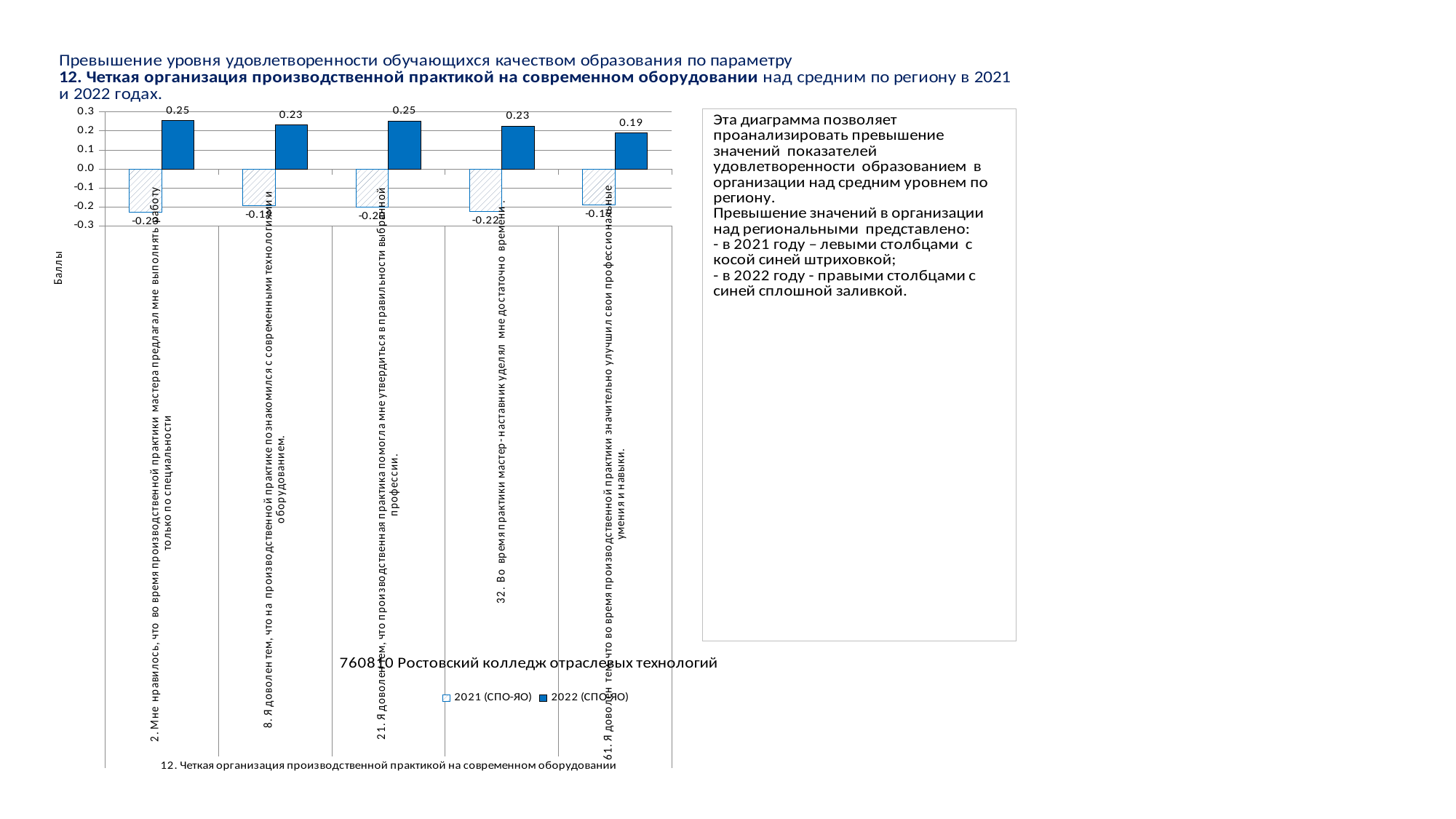
Which statement has the lowest 2022 (СПО-ЯО) value? 61. Я доволен тем, что во время производственной практики значительно улучшил свои профессиональные умения и навыки What is the title of the vertical axis? Баллы What is the 2022 (СПО-ЯО) value for statement 32 (Во время практики мастер-наставник уделял мне достаточно времени)? 0.23 How many series does the chart legend list? 2 Which has the larger 2022 (СПО-ЯО) value: statement 8 or statement 61? statement 8 What is the 2021 (СПО-ЯО) value for statement 32 (Во время практики мастер-наставник уделял мне достаточно времени)? -0.22 What kind of chart is shown on the slide? bar chart What is the 2022 (СПО-ЯО) value for statement 61 (Я доволен тем, что во время производственной практики значительно улучшил свои профессиональные умения и навыки)? 0.19 What are the two entries in the chart legend? 2021 (СПО-ЯО) and 2022 (СПО-ЯО) How many categories (survey statements) are plotted on the x axis? 5 What is the difference between the 2022 (СПО-ЯО) values for statement 2 and statement 61? 0.06 Is the 2021 (СПО-ЯО) value for statement 2 greater or less than -0.1? less